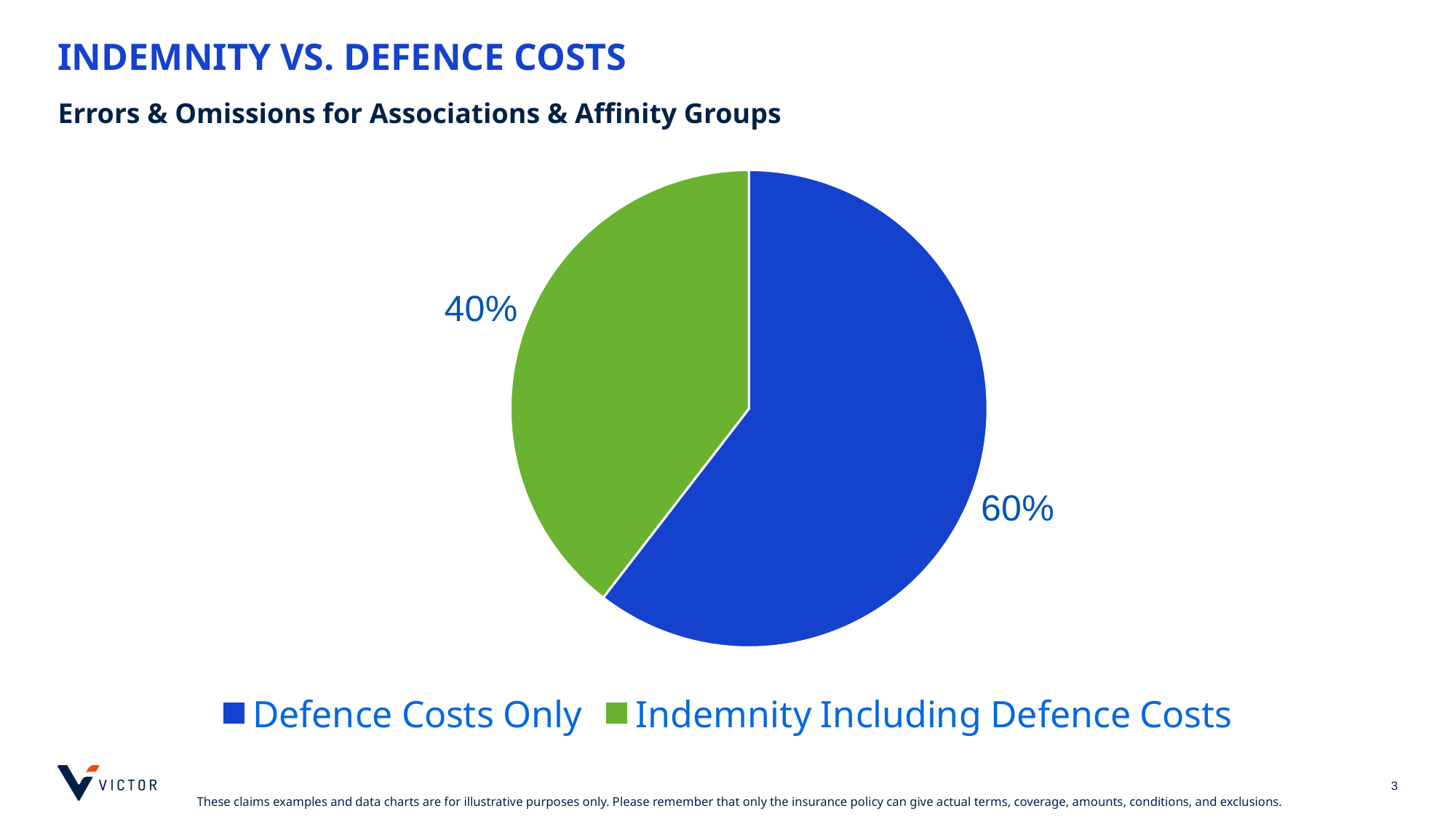
What is the difference in percentage points between Defence Costs Only and Indemnity Including Defence Costs? 20% How many slices does the pie chart have? 2 Which slice of the pie is the smallest? Indemnity Including Defence Costs What colour is the Indemnity Including Defence Costs slice? green What colour is the Defence Costs Only slice? blue What kind of chart is shown on the slide? pie chart What share of the pie is Indemnity Including Defence Costs? 40% What share of the pie is Defence Costs Only? 60% Which slice of the pie is the largest? Defence Costs Only Which is larger, Defence Costs Only or Indemnity Including Defence Costs? Defence Costs Only How many entries does the legend list? 2